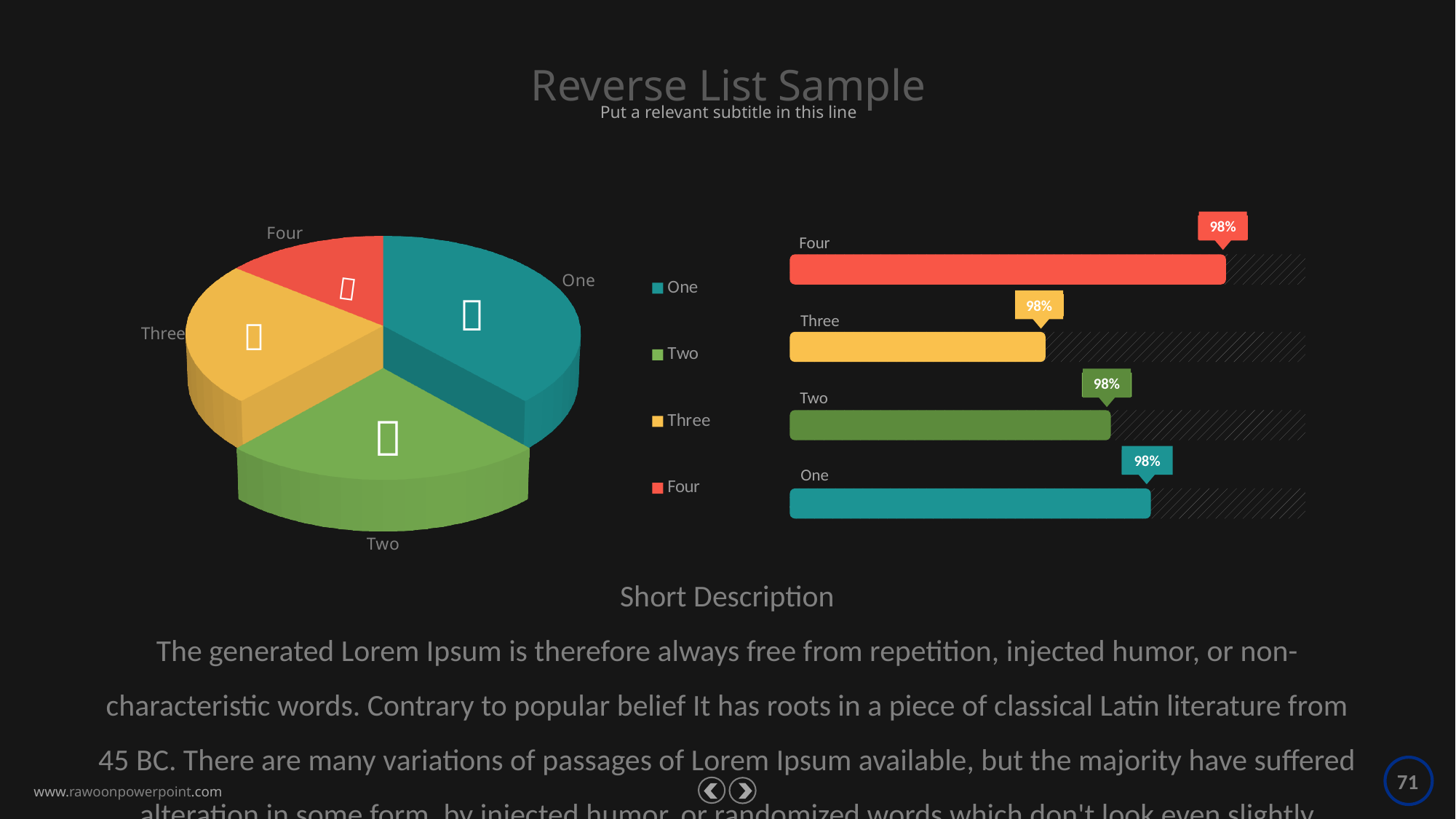
In the pie chart, which slice is larger, One or Four? One What colour is the slice labelled Four in the pie chart? red In the horizontal bar graphic on the right, what value is labelled on the bar for Four? 98% How many entries does the pie chart's legend list? 4 What colour is the slice labelled One in the pie chart? teal How many horizontal bars are shown in the bar graphic on the right of the slide? 4 Which slice of the pie chart is the smallest? Four In the horizontal bar graphic on the right, what value is labelled on the bar for One? 98% In the pie chart, which slice is larger, Two or Four? Two What kind of chart is shown on the left of the slide? pie chart How many slices does the pie chart have? 4